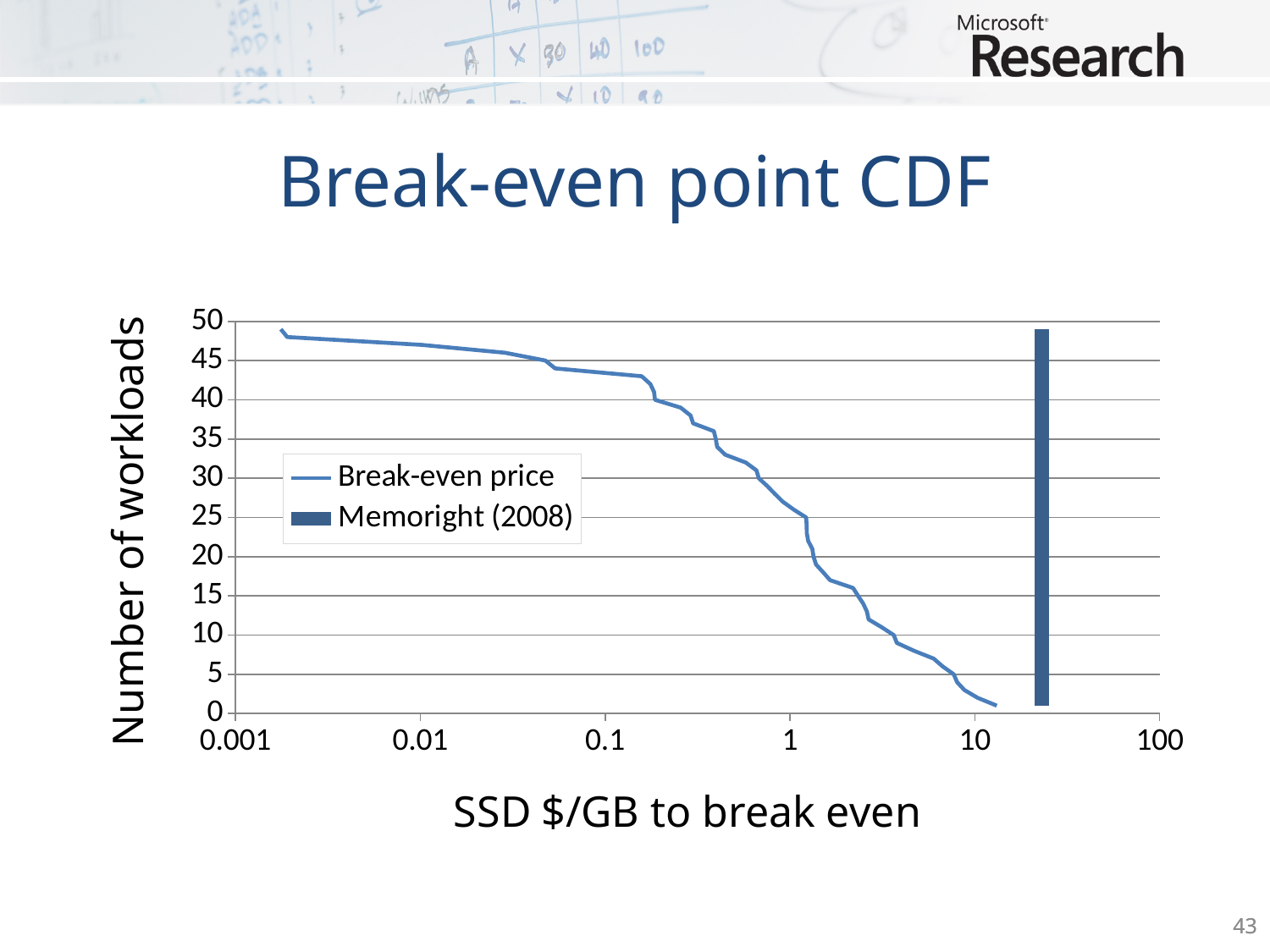
Is the number of workloads on the Break-even price line at 10 $/GB greater or less than 5? less What kind of chart is used to plot the Break-even price series? line chart Is the SSD $/GB position of the Memoright (2008) bar greater or less than 100? less How many series does the legend list? 2 Is the number of workloads on the Break-even price line at 0.1 $/GB greater or less than 40? greater What is the highest tick value shown on the y axis? 50 What is the label of the x axis? SSD $/GB to break even Does the Break-even price line rise or fall as SSD $/GB increases along the x axis? fall What is the title of the chart? Break-even point CDF